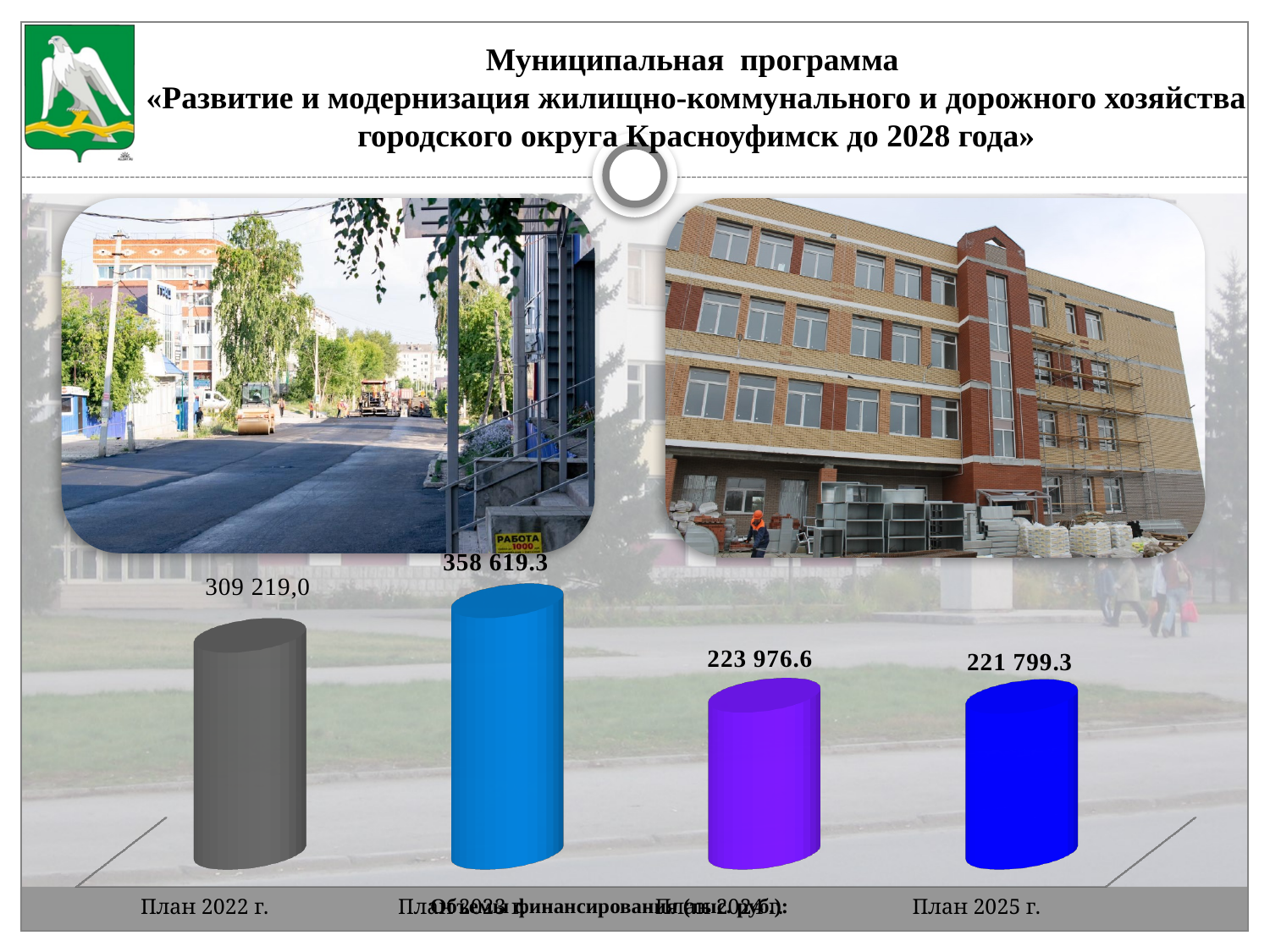
What is the difference between the values for План 2023 г. and План 2022 г.? 49 400.3 What is the value for План 2024 г.? 223 976.6 How many categories are shown in the chart? 4 What is the value for План 2023 г.? 358 619.3 Which category has the highest value? План 2023 г. What is the value for План 2025 г.? 221 799.3 What is the value for План 2022 г.? 309 219,0 What is the difference between the values for План 2024 г. and План 2025 г.? 2 177.3 Do the values rise or fall from План 2023 г. to План 2025 г.? Fall What kind of chart is shown on the slide? Bar chart Which is larger, the value for План 2024 г. or План 2025 г.? План 2024 г. Which category has the lowest value? План 2025 г.